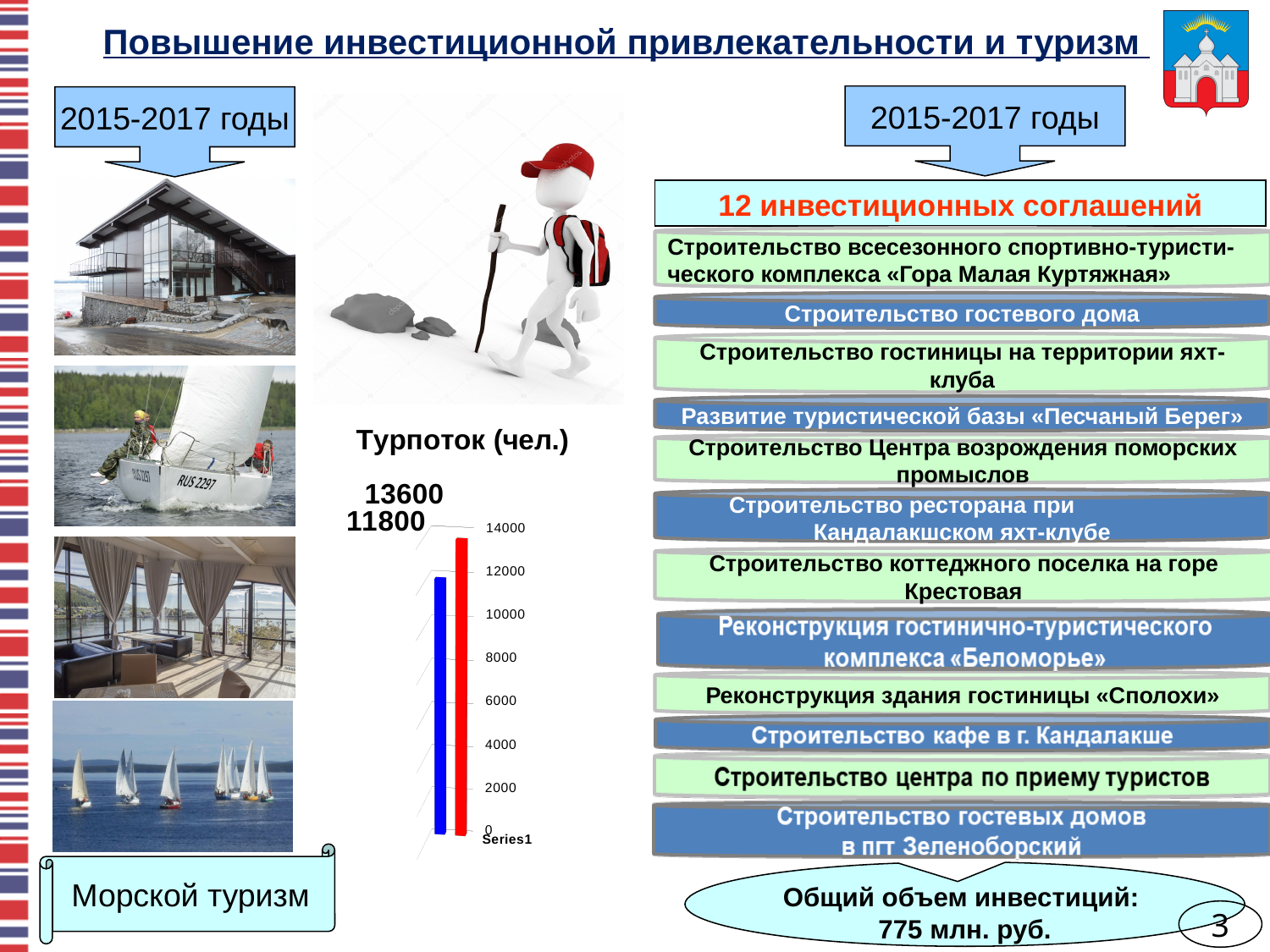
What value does the blue bar in the "Турпоток (чел.)" chart represent? 11800 What is the smallest value shown in the "Турпоток (чел.)" chart? 11800 What is the highest tick value shown on the vertical axis of the "Турпоток (чел.)" chart? 14000 What is the difference between the two values shown in the "Турпоток (чел.)" chart? 1800 What is the largest value shown in the "Турпоток (чел.)" chart? 13600 What is the title of the chart on the slide? Турпоток (чел.) How many bars are plotted in the "Турпоток (чел.)" chart? 2 What kind of chart is shown under the heading "Турпоток (чел.)"? bar chart Is the value of the blue bar in the "Турпоток (чел.)" chart greater or less than 10000? greater Which bar in the "Турпоток (чел.)" chart is taller, the blue one or the red one? the red one Is the value of the red bar in the "Турпоток (чел.)" chart greater or less than 12000? greater What value does the red bar in the "Турпоток (чел.)" chart represent? 13600